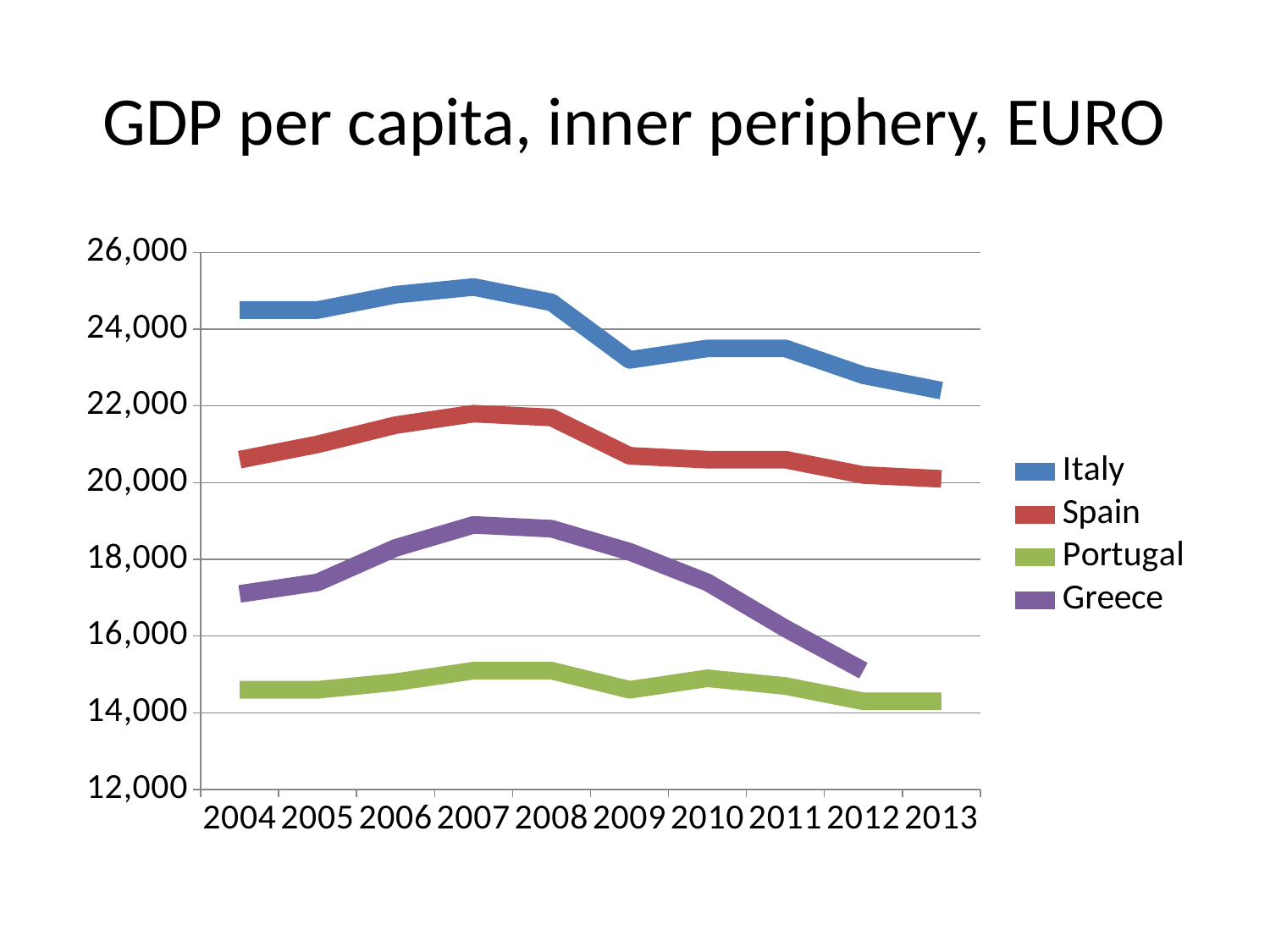
Is the value for Greece in 2004 greater or less than 18,000? less Which country has the highest GDP per capita throughout the period shown? Italy How many years are shown on the x axis? 10 In 2008, which is larger: the value for Greece or the value for Portugal? Greece Does the Greece line rise or fall from 2008 to 2012? fall Which country has the lowest GDP per capita in 2013? Portugal Is the value for Italy in 2007 greater or less than 24,000? greater How many series does the legend list? 4 What kind of chart is shown on the slide? line chart What is the title of the chart? GDP per capita, inner periphery, EURO Is the value for Greece in 2012 greater or less than 16,000? less